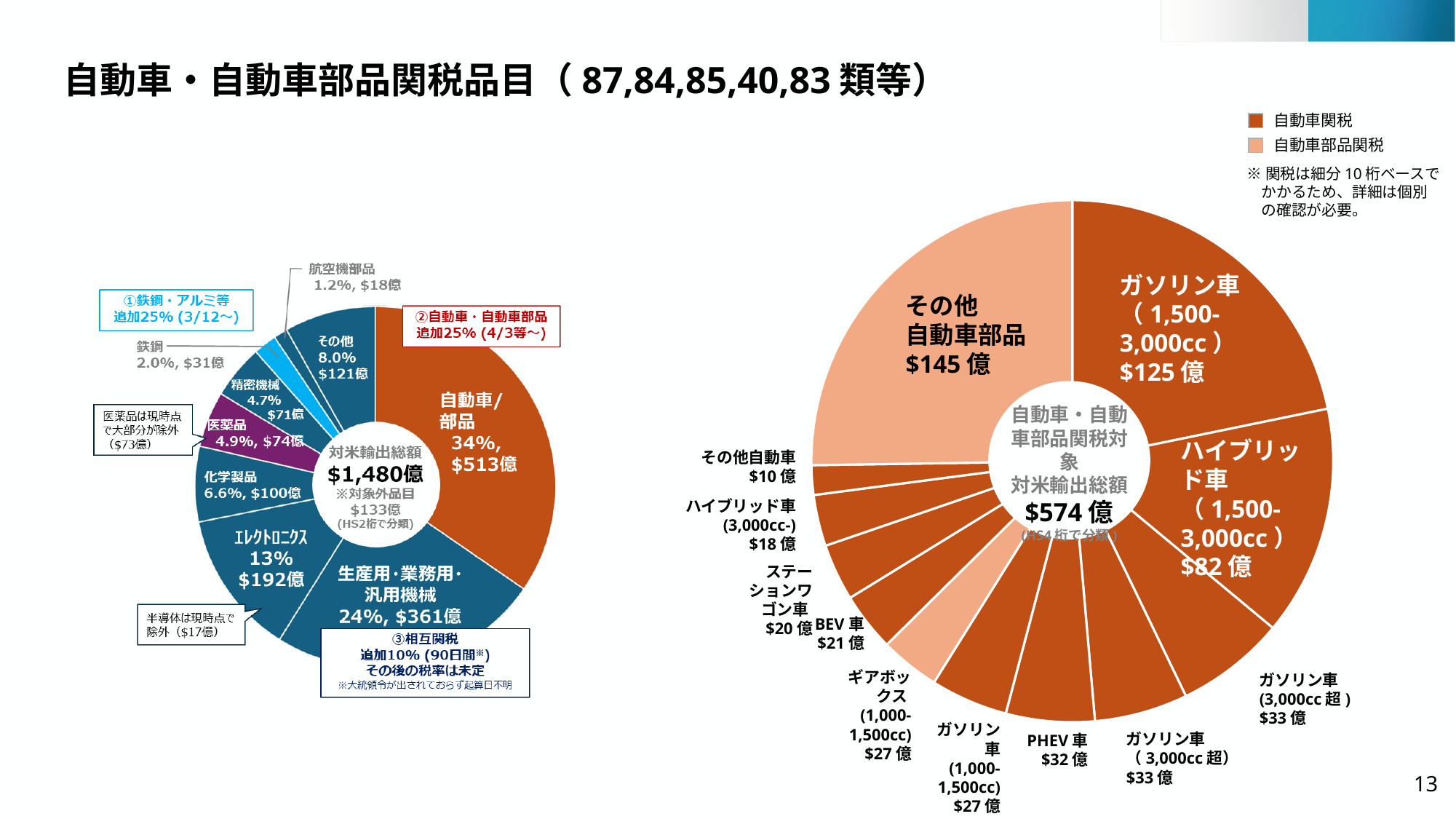
How many categories are shown in the left donut chart? 9 In the left donut chart, what is the difference in dollar value between 自動車/部品 ($513億) and 生産用・業務用・汎用機械 ($361億)? $152億 In the left donut chart, what is the value shown for エレクトロニクス? 13%, $192億 In the right pie chart, what is the value shown for ハイブリッド車 (1,500-3,000cc)? $82億 In the right pie chart, which slice is the largest? その他自動車部品 In the left donut chart, which category has the smallest share? 航空機部品 In the left donut chart (対米輸出総額 $1,480億), what is the value shown for 自動車/部品? 34%, $513億 In the left donut chart, which category has the largest share? 自動車/部品 In the right pie chart (自動車・自動車部品関税対象), what is the value shown for その他自動車部品? $145億 In the right pie chart, what is the difference between ガソリン車 (1,500-3,000cc) at $125億 and BEV車 at $21億? $104億 How many entries does the legend of the right pie chart list? 2 In the left donut chart, which is larger: 医薬品 or 鉄鋼? 医薬品